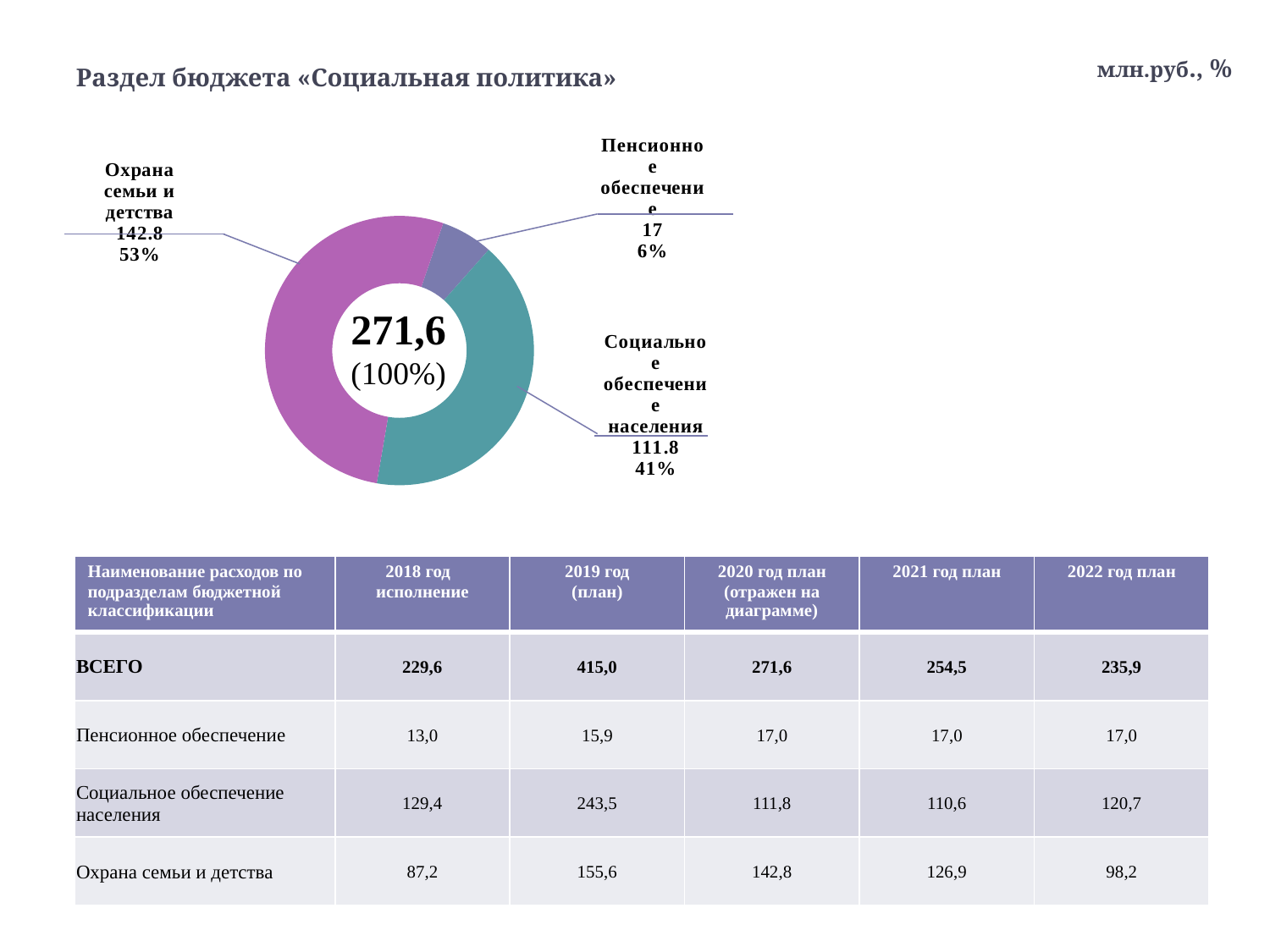
What value is shown for «Охрана семьи и детства» on the chart? 142.8 What share of the chart does «Социальное обеспечение населения» represent? 41% Which is larger on the chart: «Социальное обеспечение населения» or «Пенсионное обеспечение»? Социальное обеспечение населения What share of the chart does «Пенсионное обеспечение» represent? 6% How many slices does the donut chart have? 3 What share of the chart does «Охрана семьи и детства» represent? 53% What value is shown for «Социальное обеспечение населения» on the chart? 111.8 Which category has the smallest slice in the chart? Пенсионное обеспечение What type of chart is shown on the slide? Pie (donut) chart What value is shown for «Пенсионное обеспечение» on the chart? 17 Which category has the largest slice in the chart? Охрана семьи и детства What total value is shown in the centre of the donut chart? 271,6